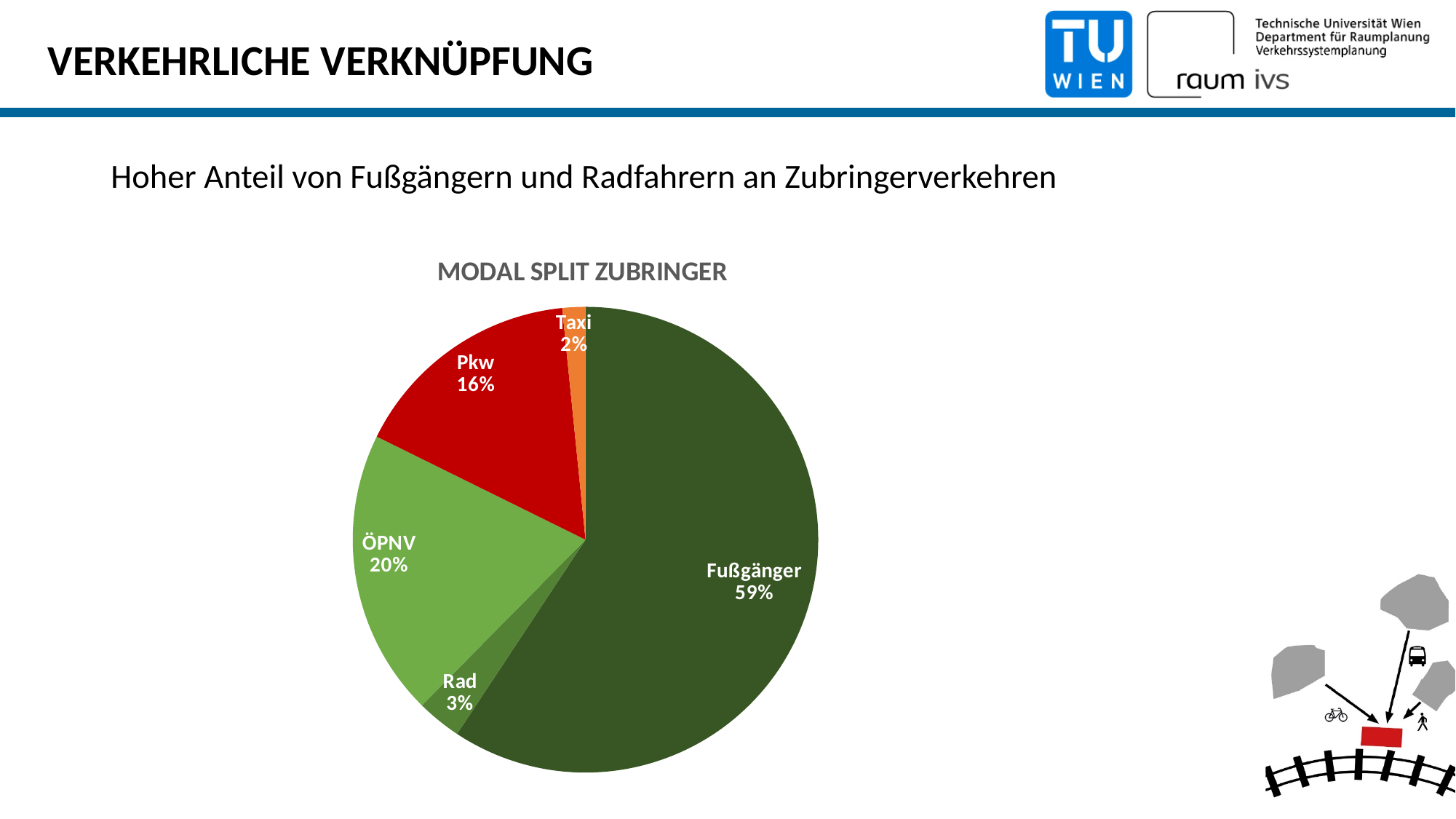
What kind of chart is shown on the slide? pie chart What is the value for ÖPNV? 20% Which category has the smallest slice? Taxi What share of the pie does Fußgänger have? 59% What is the value for Rad? 3% What is the value for Taxi? 2% What is the value for Pkw? 16% How many categories are shown in the pie chart? 5 What is the title of the chart? MODAL SPLIT ZUBRINGER What is the difference between the ÖPNV and Pkw shares? 4% Which is larger, the share for Pkw or the share for ÖPNV? ÖPNV Which category has the largest slice? Fußgänger